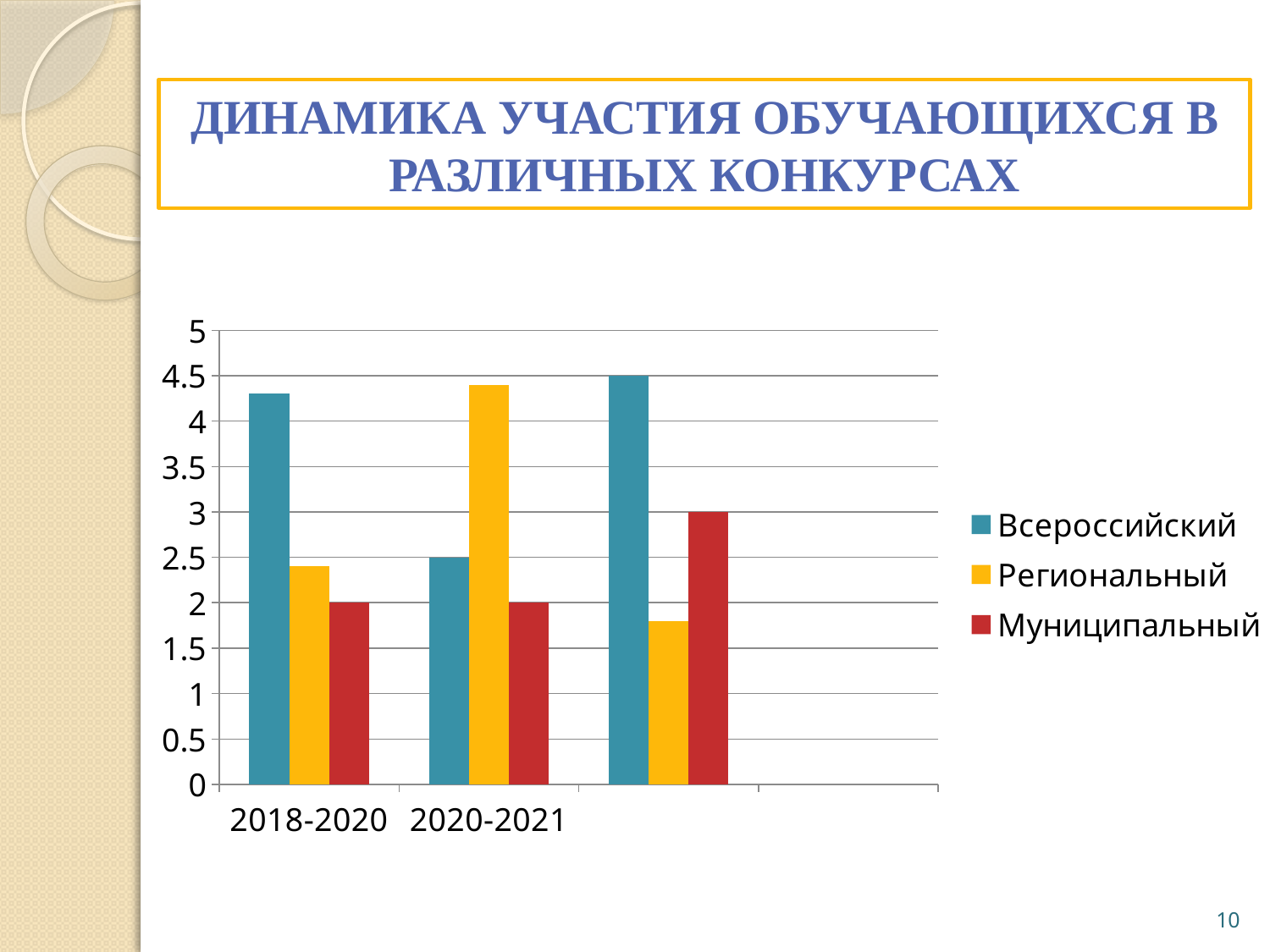
Is the value for Региональный in 2018-2020 greater or less than 3? less What kind of chart is shown on the slide? bar chart Is the value for Всероссийский in 2018-2020 greater or less than 4? greater What is the value for Всероссийский in 2020-2021? 2.5 What is the difference between Всероссийский and Муниципальный in 2020-2021? 0.5 What is the value for Муниципальный in 2020-2021? 2 Is the value for Региональный in 2020-2021 greater or less than 4? greater Does the value for Всероссийский rise or fall from 2018-2020 to 2020-2021? fall Which series has the highest value in 2018-2020? Всероссийский What is the value for Муниципальный in 2018-2020? 2 How many series does the legend list? 3 Which series has the highest value in 2020-2021? Региональный